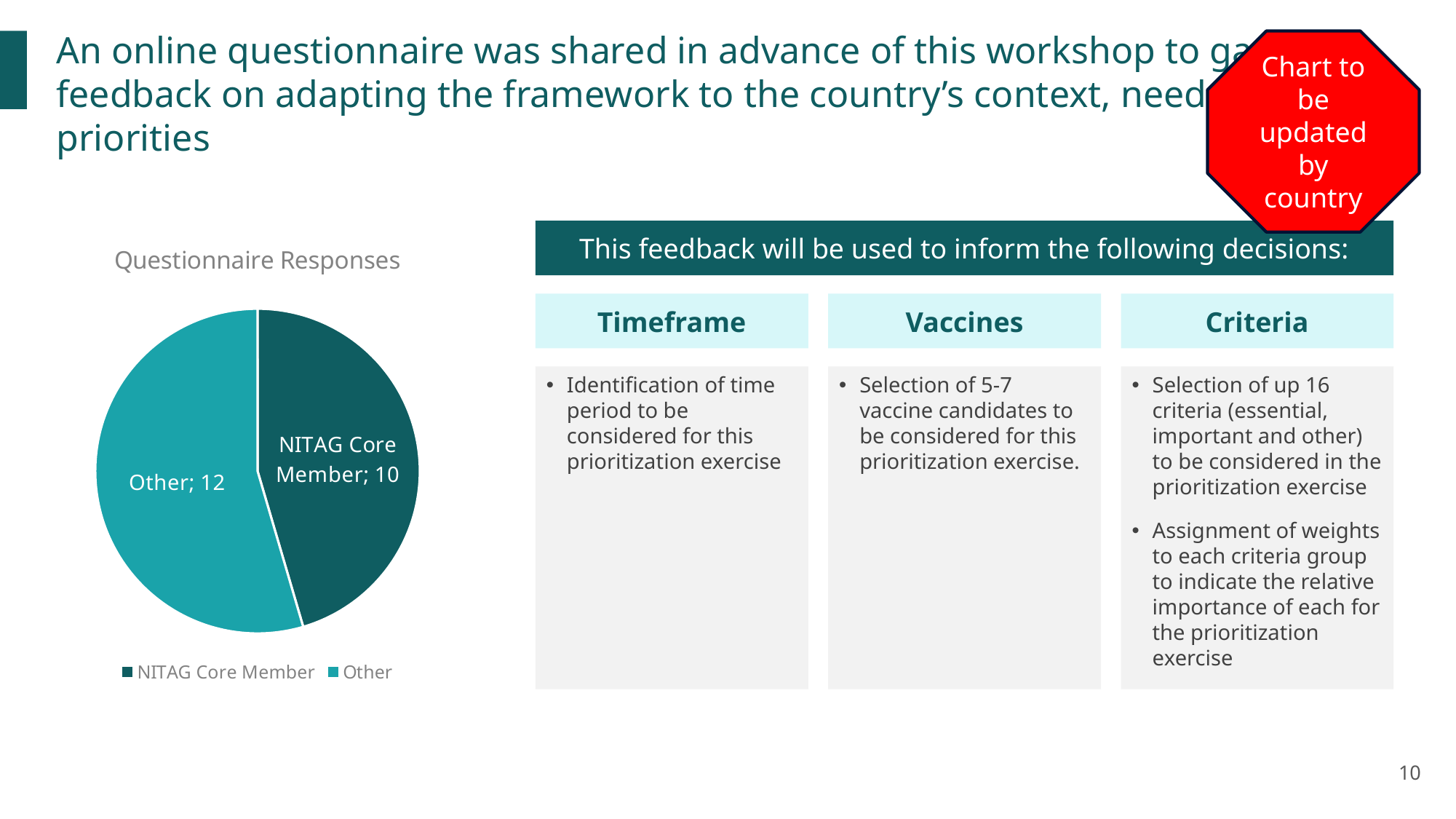
Which legend entry is shown in the darker teal colour? NITAG Core Member What is the title of the chart? Questionnaire Responses What is the difference between the Other and NITAG Core Member responses? 2 Which category has the larger number of responses? Other How many slices does the pie chart have? 2 How many responses are in the Other category? 12 How many entries does the legend list? 2 What is the total number of questionnaire responses shown in the pie chart? 22 What type of chart is shown on the slide? pie chart How many responses are from NITAG Core Members? 10 Is the value for Other larger or smaller than the value for NITAG Core Member? larger Which category has the smaller number of responses? NITAG Core Member